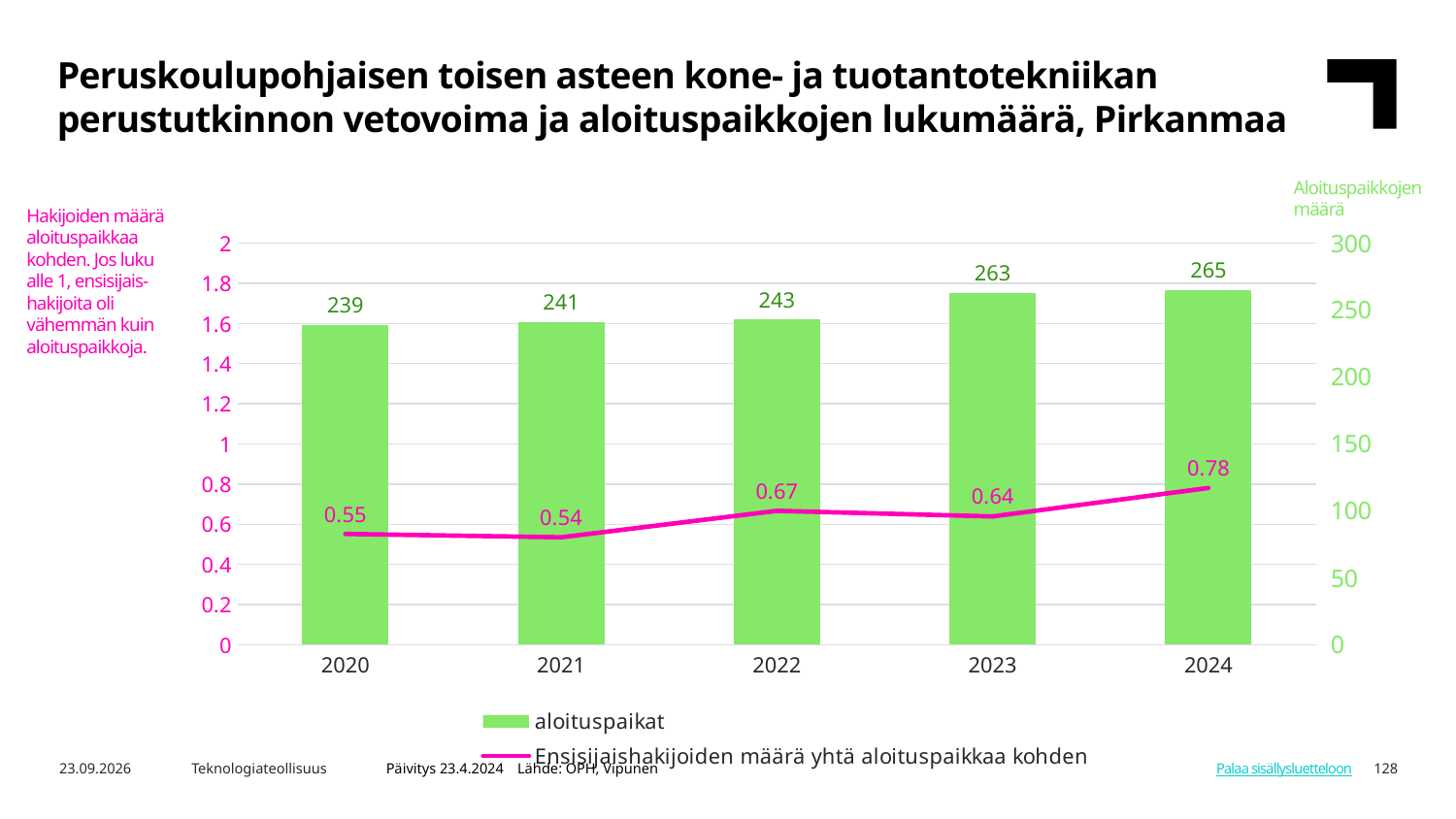
Which year has the highest value of aloituspaikat? 2024 Which year has a larger value of Ensisijaishakijoiden määrä yhtä aloituspaikkaa kohden, 2022 or 2023? 2022 What is the value of Ensisijaishakijoiden määrä yhtä aloituspaikkaa kohden for 2021? 0.54 Which year has the lowest value of Ensisijaishakijoiden määrä yhtä aloituspaikkaa kohden? 2021 What is the difference in aloituspaikat between 2024 and 2020? 26 What is the value of aloituspaikat for 2020? 239 What colour are the aloituspaikat bars? green How many years are shown on the x axis? 5 Does the value of aloituspaikat rise or fall from 2020 to 2024? rise How many series does the legend list? 2 What is the value of Ensisijaishakijoiden määrä yhtä aloituspaikkaa kohden for 2024? 0.78 What is the value of aloituspaikat for 2023? 263